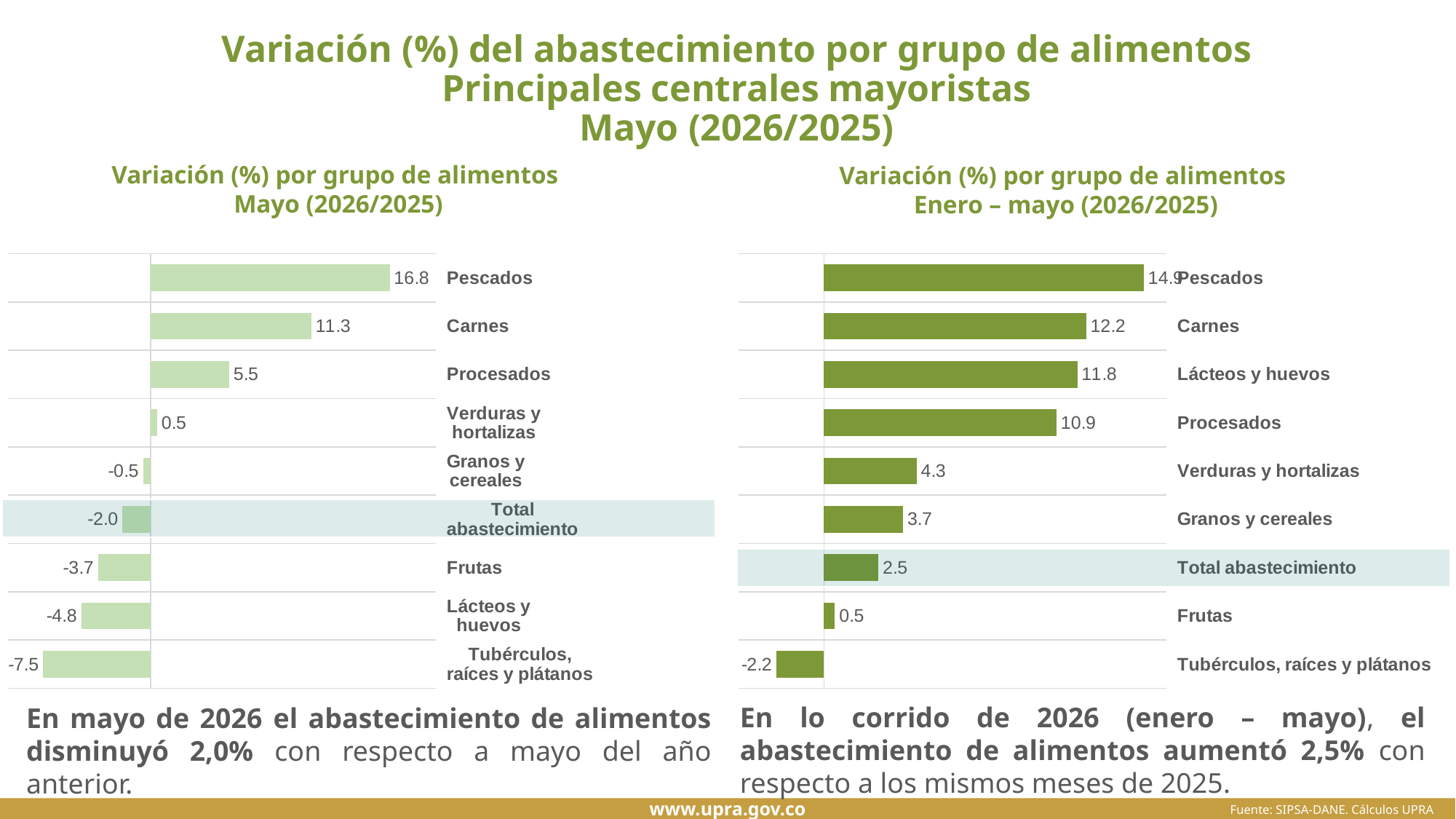
In the right chart (Enero – mayo 2026/2025), which is larger, the value for Procesados or the value for Verduras y hortalizas? Procesados In the left chart (Mayo 2026/2025), what is the value for Total abastecimiento? -2.0 In the left chart (Mayo 2026/2025), what is the difference between the values for Pescados and Carnes? 5.5 In the left chart (Mayo 2026/2025), which food group has the lowest value? Tubérculos, raíces y plátanos In the right chart (Enero – mayo 2026/2025), which food group has the lowest value? Tubérculos, raíces y plátanos In the right chart (Enero – mayo 2026/2025), what is the value for Total abastecimiento? 2.5 What type of chart is the left chart (Mayo 2026/2025)? Bar chart In the left chart (Mayo 2026/2025), how many categories are plotted? 9 In the right chart (Enero – mayo 2026/2025), what is the difference between the values for Carnes and Granos y cereales? 8.5 In the left chart (Mayo 2026/2025), which food group has the highest value? Pescados In the right chart (Enero – mayo 2026/2025), what is the value for Lácteos y huevos? 11.8 In the left chart (Mayo 2026/2025), what is the value for Carnes? 11.3